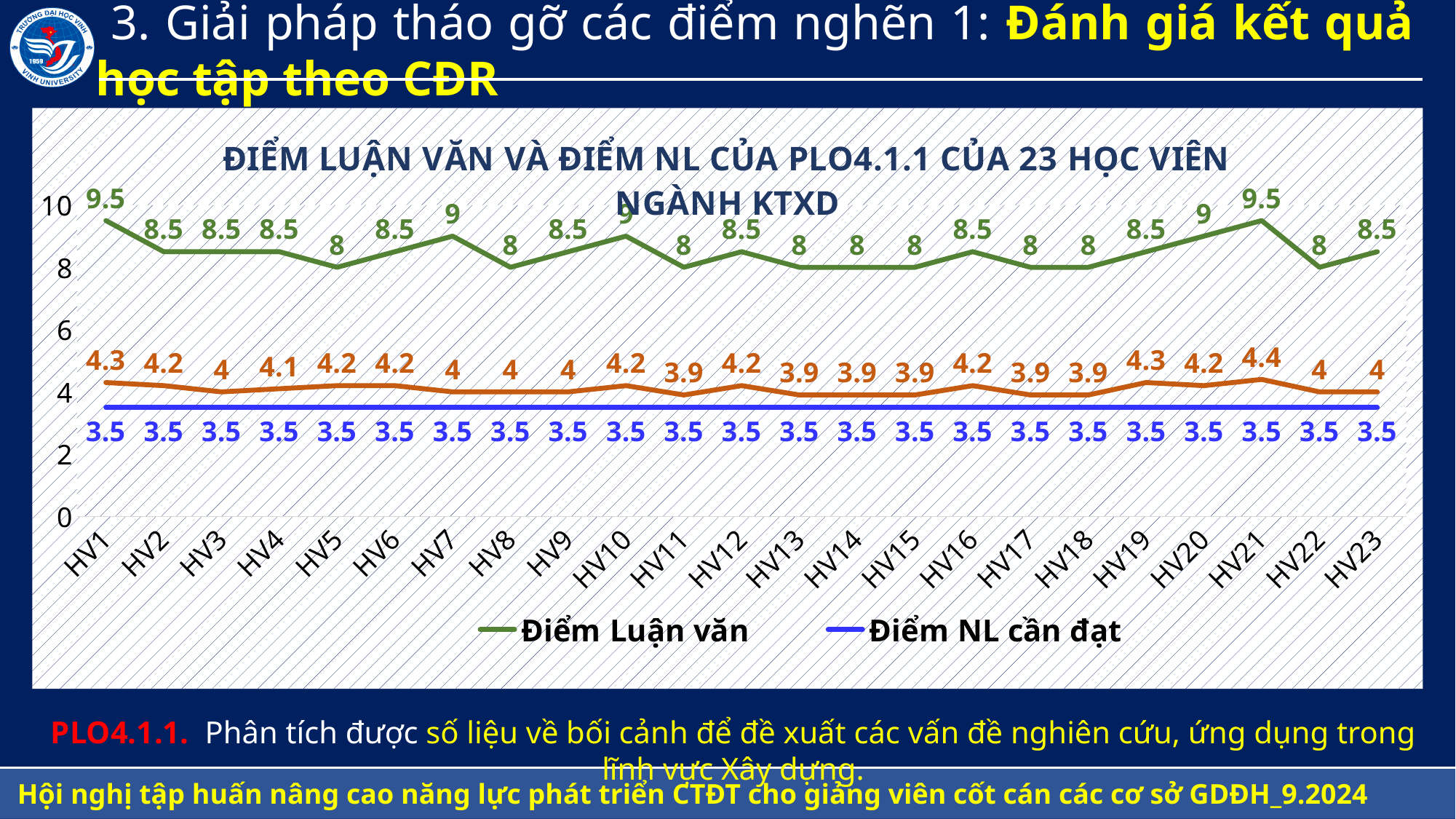
What is the Điểm NL cần đạt value for HV10? 3.5 Does the Điểm NL cần đạt line rise, fall, or stay constant from HV1 to HV23? Stays constant Which has a higher Điểm Luận văn value, HV1 or HV5? HV1 How many học viên (HV categories) are shown on the x axis? 23 What is the value of the orange line at HV21? 4.4 What is the Điểm Luận văn value for HV7? 9 How many series does the legend list? 2 What is the lowest Điểm Luận văn value shown on the chart? 8 What is the Điểm Luận văn value for HV21? 9.5 What kind of chart is shown on the slide? Line chart What is the highest Điểm Luận văn value shown on the chart? 9.5 What is the difference between the Điểm Luận văn and Điểm NL cần đạt values for HV1? 6